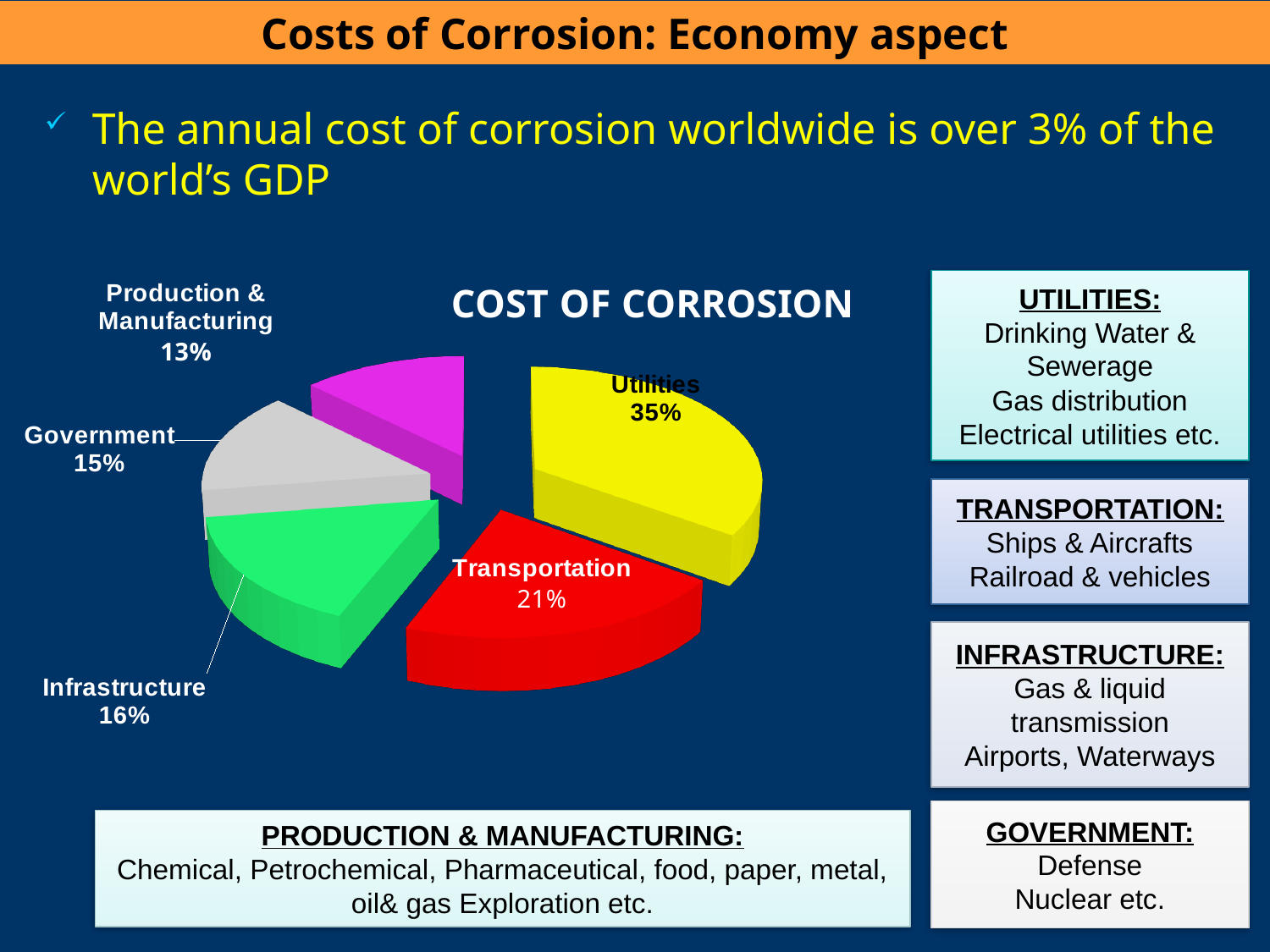
What share of the cost of corrosion is attributed to Utilities? 35% Which sector accounts for the smallest share of the cost of corrosion? Production & Manufacturing Which sector accounts for the largest share of the cost of corrosion? Utilities What is the difference in percentage points between the Utilities and Transportation shares? 14 What is the title of the chart? COST OF CORROSION What share of the cost of corrosion is attributed to Infrastructure? 16% What kind of chart is shown on the slide? Pie chart Which slice is larger, Infrastructure or Government? Infrastructure How many sectors are shown in the pie chart? 5 What share of the cost of corrosion is attributed to Government? 15% What share of the cost of corrosion is attributed to Transportation? 21% What share of the cost of corrosion is attributed to Production & Manufacturing? 13%